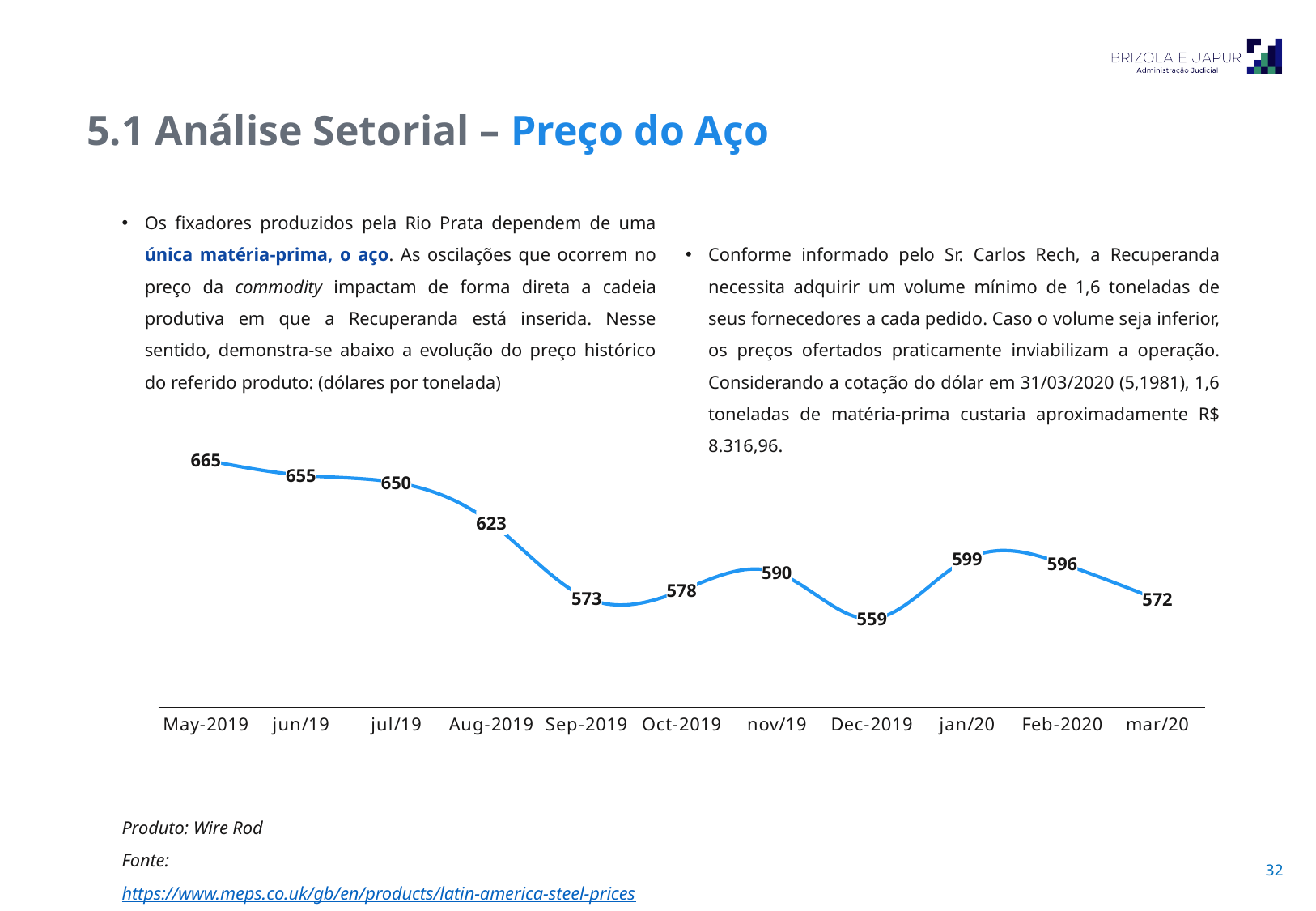
What is the difference between the values for jan/20 and mar/20? 27 Which month has the lowest value on the chart? Dec-2019 What is the value plotted for Dec-2019? 559 How many data points are plotted on the chart? 11 What is the steel price value for May-2019? 665 Do the values rise or fall from May-2019 to Sep-2019? fall Which month has the highest value on the chart? May-2019 What is the difference between the values for May-2019 and Dec-2019? 106 Which is larger, the value for Sep-2019 or the value for nov/19? nov/19 What is the value plotted for mar/20? 572 What is the value plotted for Aug-2019? 623 What type of chart is shown on the slide? line chart